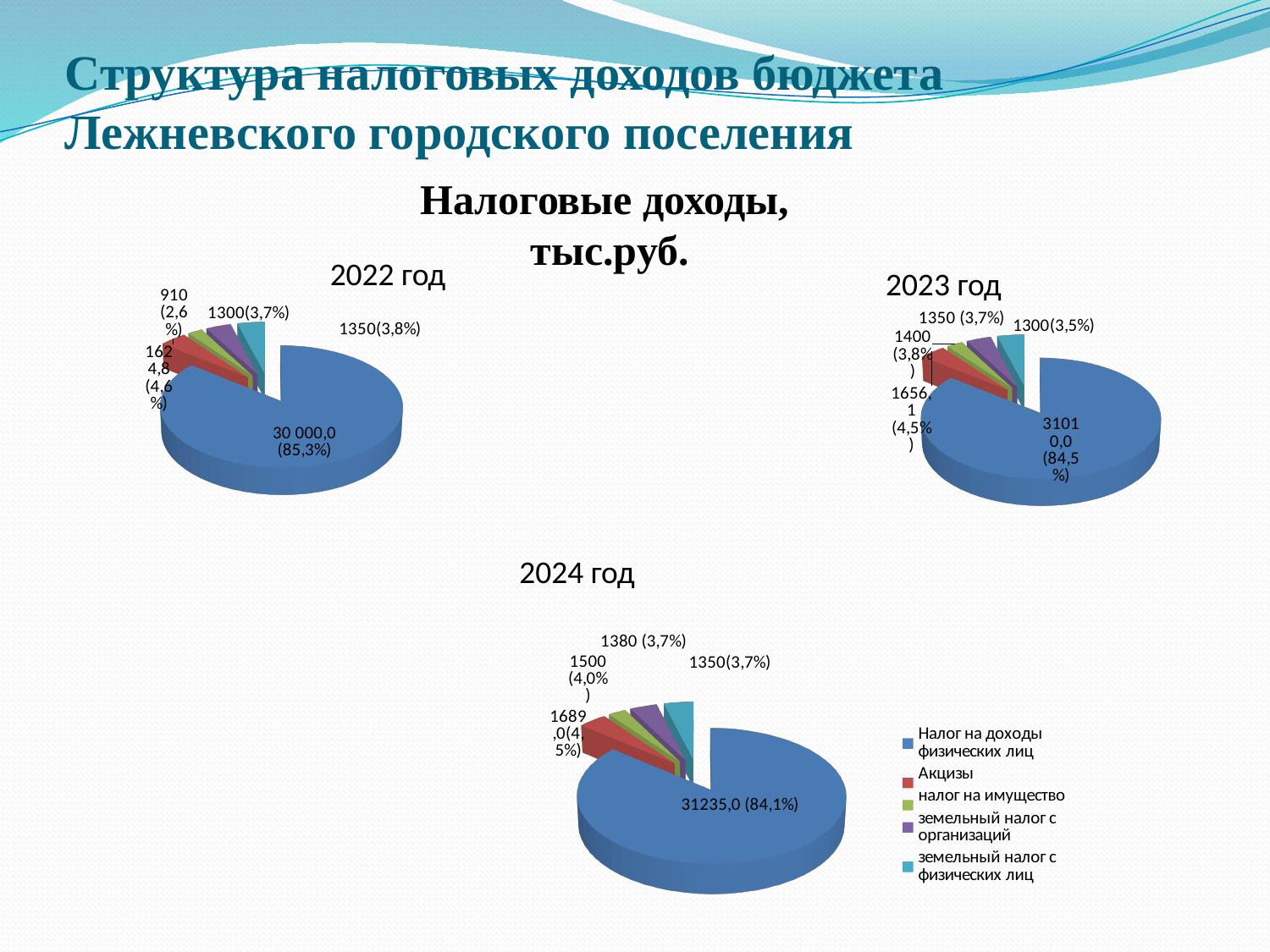
Which category is listed first in the legend? Налог на доходы физических лиц In the 2022 год chart, what share of the pie does the largest slice represent? 85,3% In the 2023 год chart, what share of the pie does the largest slice represent? 84,5% In the 2022 год chart, what is the value of the smallest slice? 910 In the 2023 год chart, what is the value of the smallest slice? 1300 What kind of charts are shown on the slide? Pie charts In the 2023 год chart, what is the value of the largest slice? 31010,0 How many series does the legend list? 5 In the 2024 год chart, what is the value of the largest slice? 31235,0 In the 2022 год chart, what is the value of the largest slice? 30 000,0 In the 2024 год chart, what share of the pie does the largest slice represent? 84,1% Which is larger: the largest slice in the 2022 год chart or the largest slice in the 2024 год chart? 2024 год